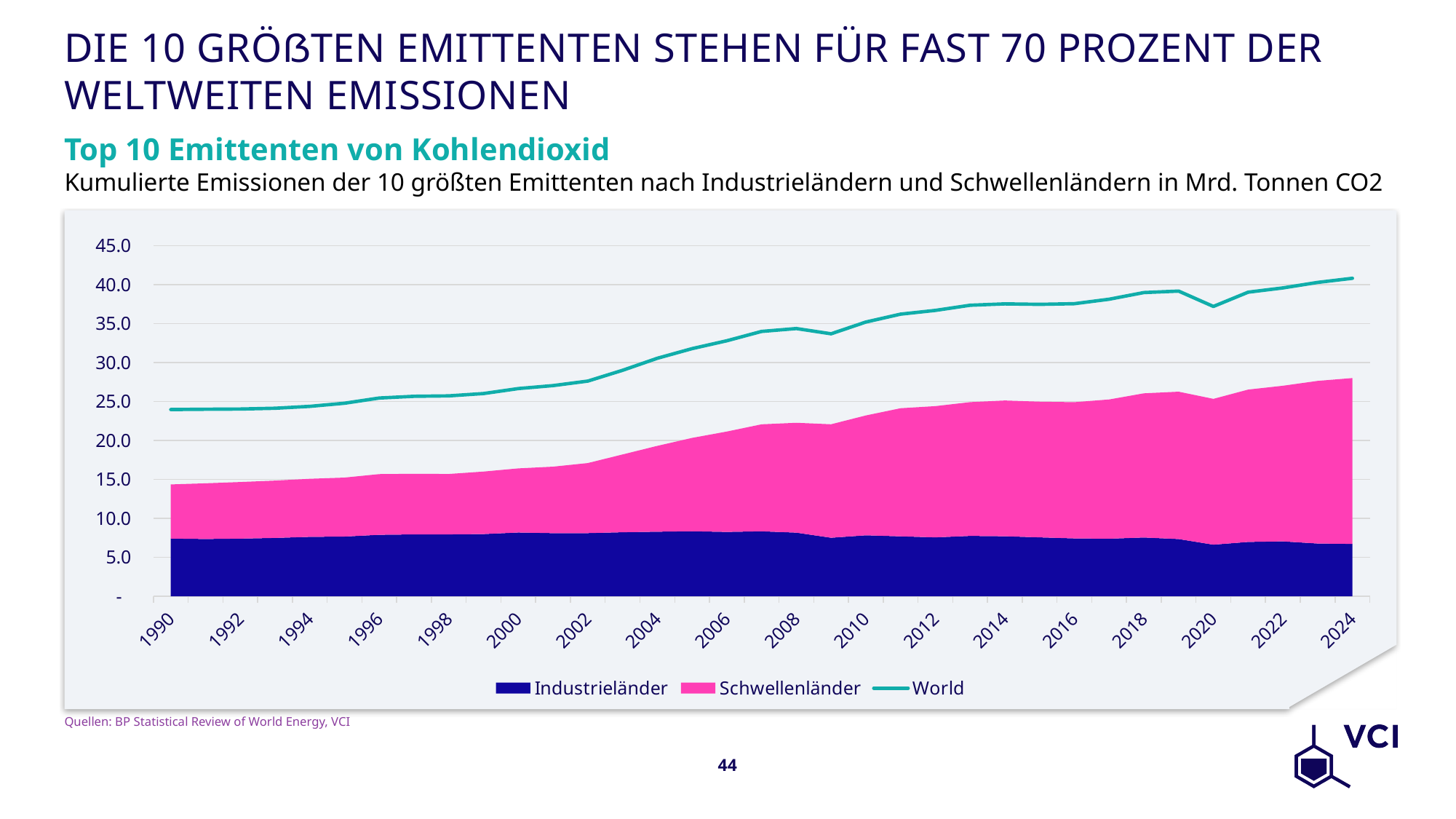
How many years are labelled on the x axis? 18 Is the World value for 2000 greater or less than 25.0? greater Which is larger, the World value for 2019 or for 2020? 2019 Is the World value for 2020 greater or less than 40.0? less In which year does the World line reach its highest value? 2024 How many series does the legend list? 3 Which series are listed in the legend? Industrieländer, Schwellenländer, World Is the Industrieländer value for 2024 greater or less than 10.0? less What is the title of the chart? Top 10 Emittenten von Kohlendioxid Does the World line rise or fall from 1990 to 2024? Rises What kind of chart is shown on the slide? Stacked area chart with a line